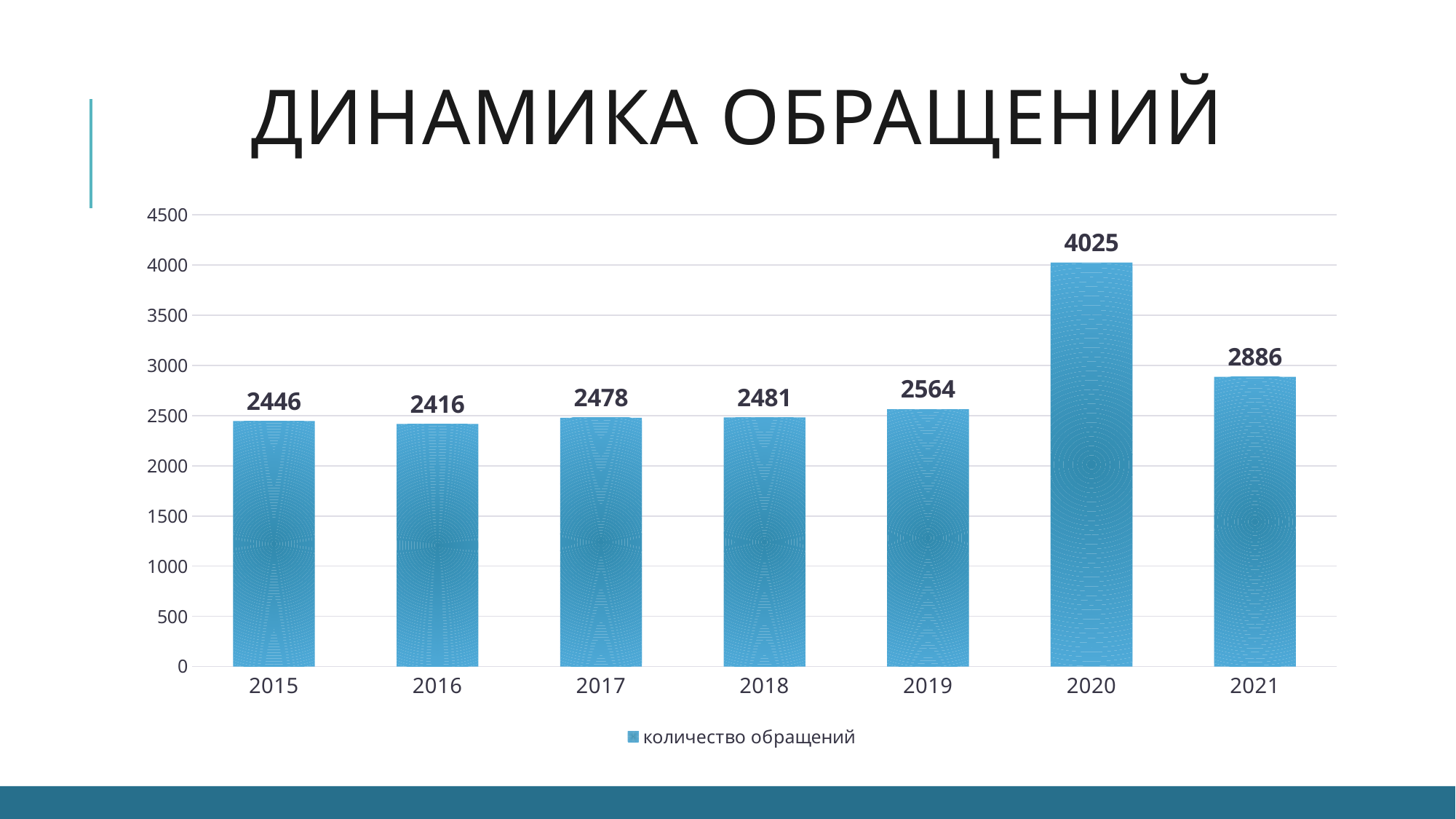
What is the value for 2021? 2886 Which year has the highest value? 2020 What kind of chart is shown on the slide? bar chart Which year has the lowest value? 2016 Which is larger, the value for 2015 or the value for 2016? 2015 What is the difference between the values for 2020 and 2021? 1139 What is the value for 2019? 2564 What is the difference between the values for 2019 and 2018? 83 What is the title of the chart on the slide? ДИНАМИКА ОБРАЩЕНИЙ What is the value for 2015? 2446 How many years are shown on the x axis? 7 Is the value for 2020 greater or less than 4000? greater